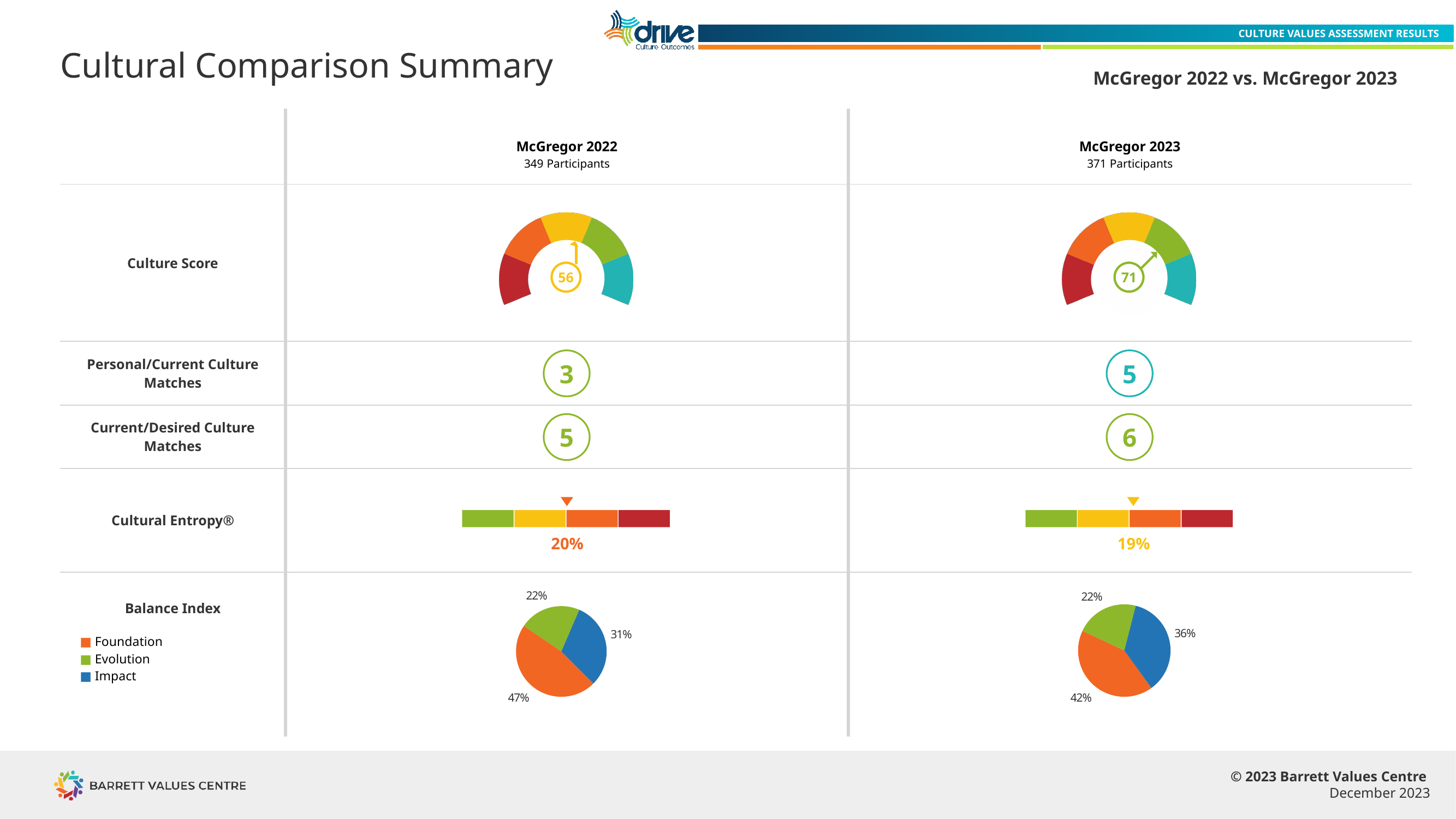
How many categories does the Balance Index legend list? 3 In the McGregor 2023 Balance Index pie chart, what share is Impact? 36% Which colour represents Evolution in the Balance Index pie charts? Green In the McGregor 2022 Balance Index pie chart, which category has the largest share? Foundation What type of chart is used for the Balance Index? Pie chart In the Balance Index pie charts, is the Impact share larger for McGregor 2022 or McGregor 2023? McGregor 2023 In the McGregor 2023 Balance Index pie chart, which category has the smallest share? Evolution What is the difference between the McGregor 2023 and McGregor 2022 Culture Scores? 15 In the McGregor 2022 Balance Index pie chart, what is the difference between the Foundation and Impact shares? 16% What is the Culture Score shown on the McGregor 2023 gauge? 71 What is the Culture Score shown on the McGregor 2022 gauge? 56 In the McGregor 2022 Balance Index pie chart, what share is Foundation? 47%